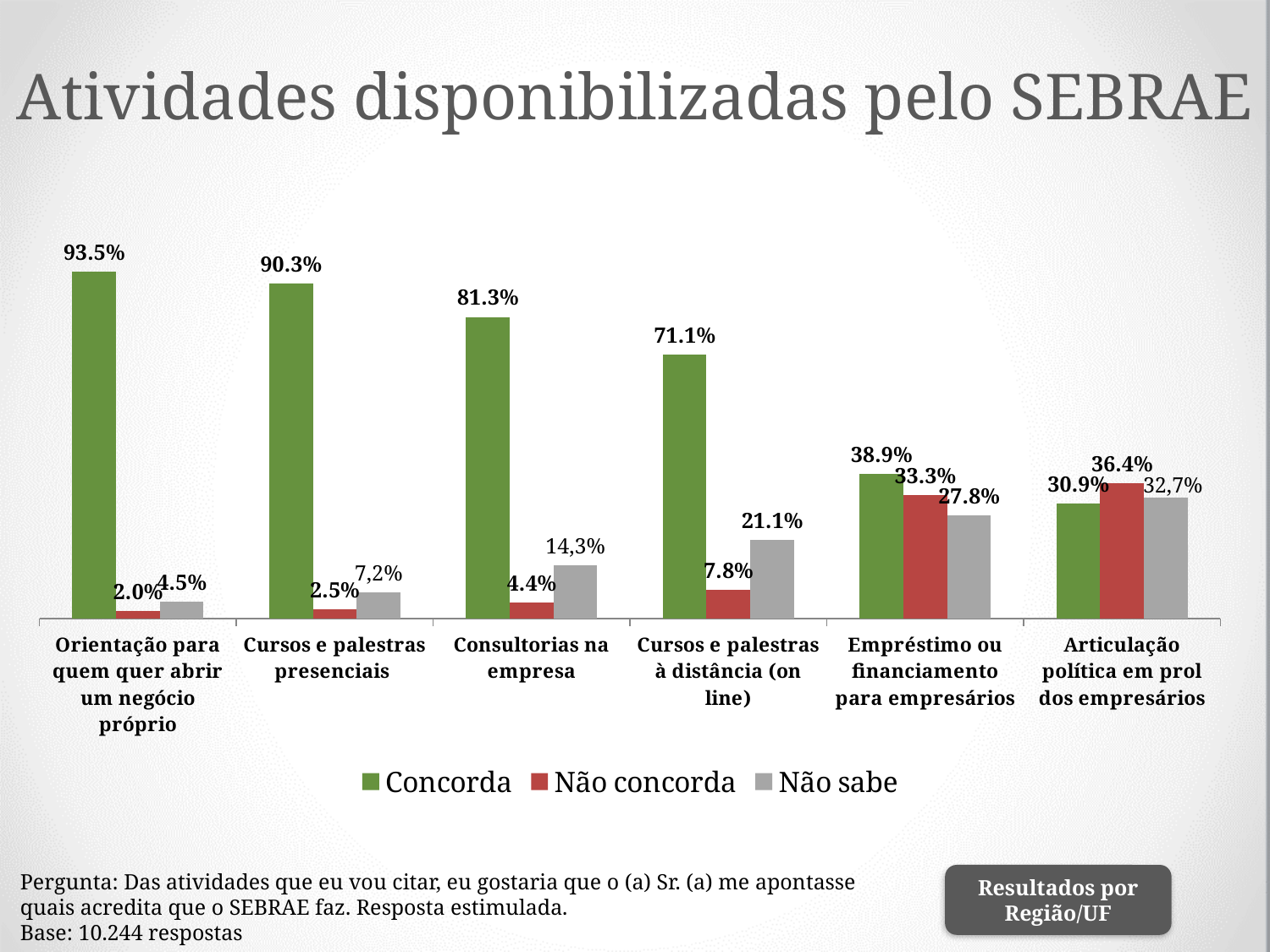
What is the Não concorda value for "Cursos e palestras à distância (on line)"? 7.8% What kind of chart is shown on the slide? Bar chart How many series does the legend list? 3 Which activity has the highest Não concorda value? Articulação política em prol dos empresários What is the Não sabe value for "Consultorias na empresa"? 14,3% What is the Concorda value for "Orientação para quem quer abrir um negócio próprio"? 93.5% For "Articulação política em prol dos empresários", which is larger: Concorda or Não concorda? Não concorda Which activity has the lowest Concorda value? Articulação política em prol dos empresários Do the Concorda values rise or fall from left to right across the categories? Fall Which activity has the highest Concorda value? Orientação para quem quer abrir um negócio próprio For "Empréstimo ou financiamento para empresários", what is the difference between the Concorda and Não concorda values? 5.6 percentage points How many activities (categories) are shown on the x axis? 6